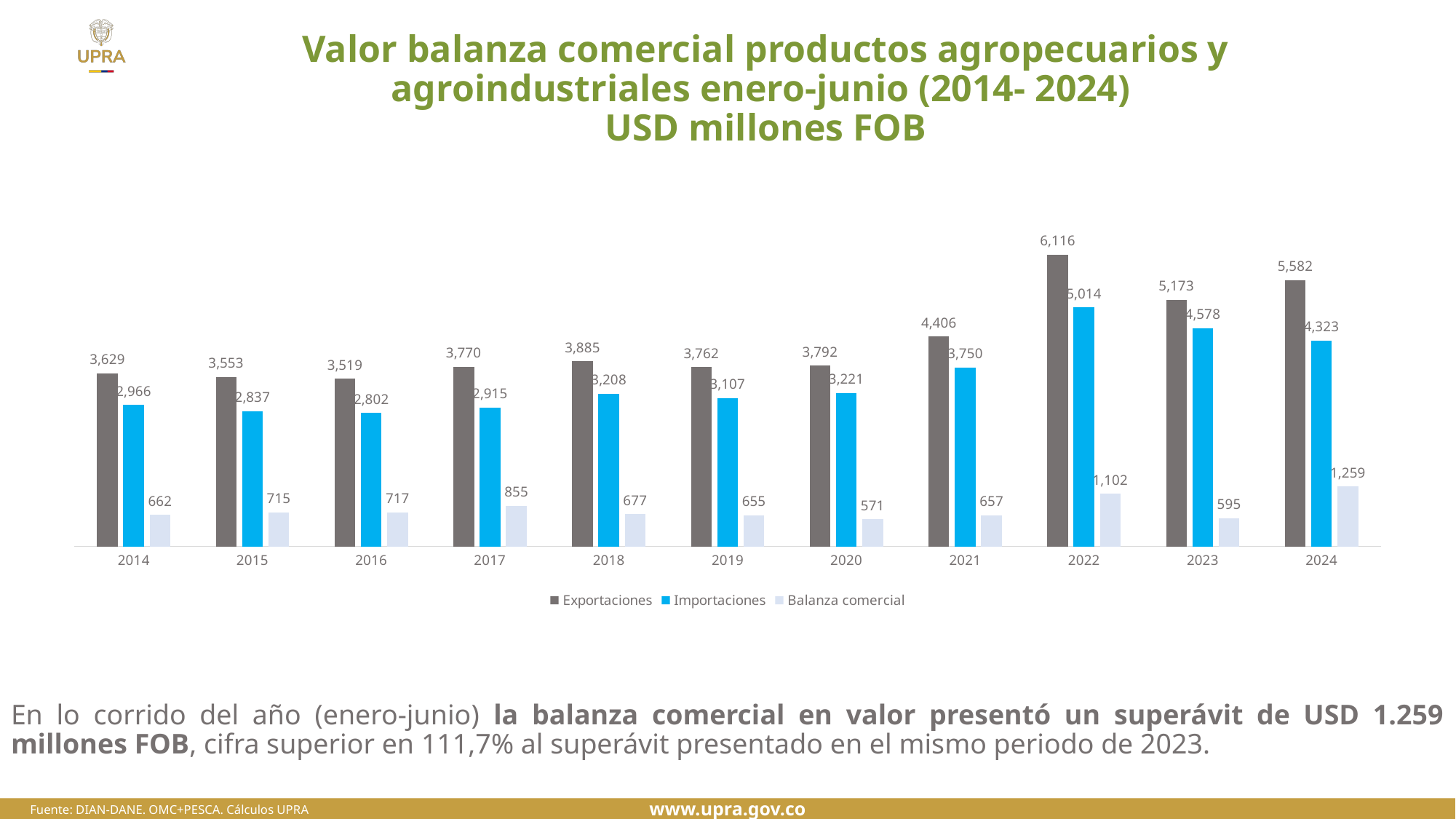
What kind of chart is shown on the slide? Bar chart Which year has the highest Exportaciones value? 2022 Which year has the lowest Balanza comercial value? 2020 Did the Balanza comercial rise or fall from 2023 to 2024? Rise What is the value of Balanza comercial in 2024? 1,259 What is the value of Importaciones in 2016? 2,802 What is the difference between Exportaciones and Importaciones in 2024? 1,259 Which colour represents Importaciones in the chart? Blue How many years are shown on the x axis? 11 How many series does the legend list? 3 Which is larger, Importaciones in 2021 or Importaciones in 2023? Importaciones in 2023 What is the value of Exportaciones in 2022? 6,116